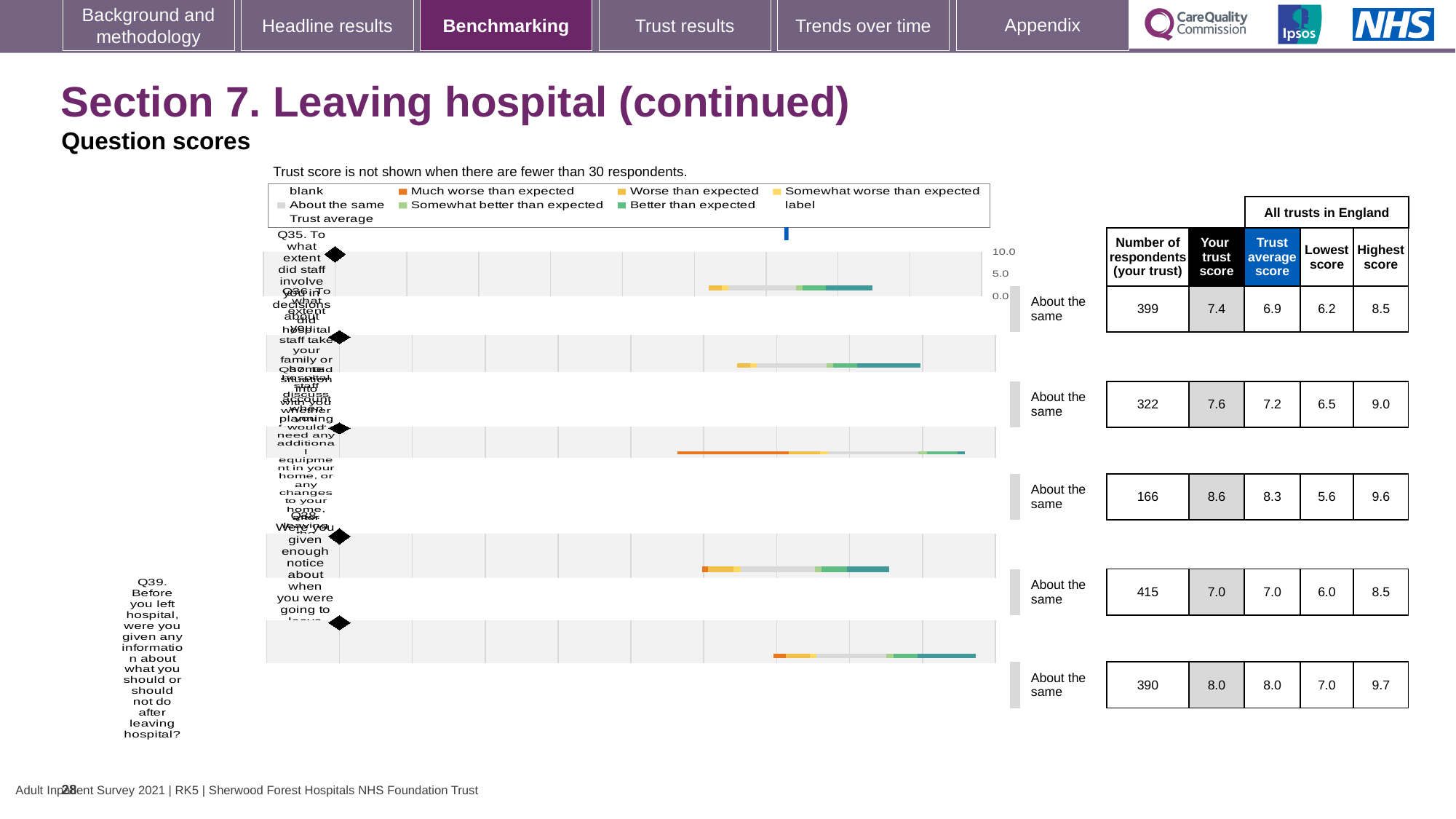
Which question has the lowest trust score? Q38 What is the highest score across all trusts in England for Q37 (the third row)? 9.6 Which question has the highest trust score? Q37 What is the difference between the trust score and the trust average score for Q37 (the third row)? 0.3 What is the number of respondents for Q38 (enough notice about when you were going to leave hospital)? 415 What is the lowest score across all trusts in England for Q35 (the first row)? 6.2 What kind of chart is used to show the question scores on this slide? bar chart What is the trust score for Q39 (information about what you should or should not do after leaving hospital)? 8.0 What benchmark category is shown for every question on this slide? About the same For Q36 (the second row), which is larger: the trust score or the trust average score? Trust score How many questions (rows) are plotted in the chart? 5 What is the trust average score for Q39 (the last row)? 8.0